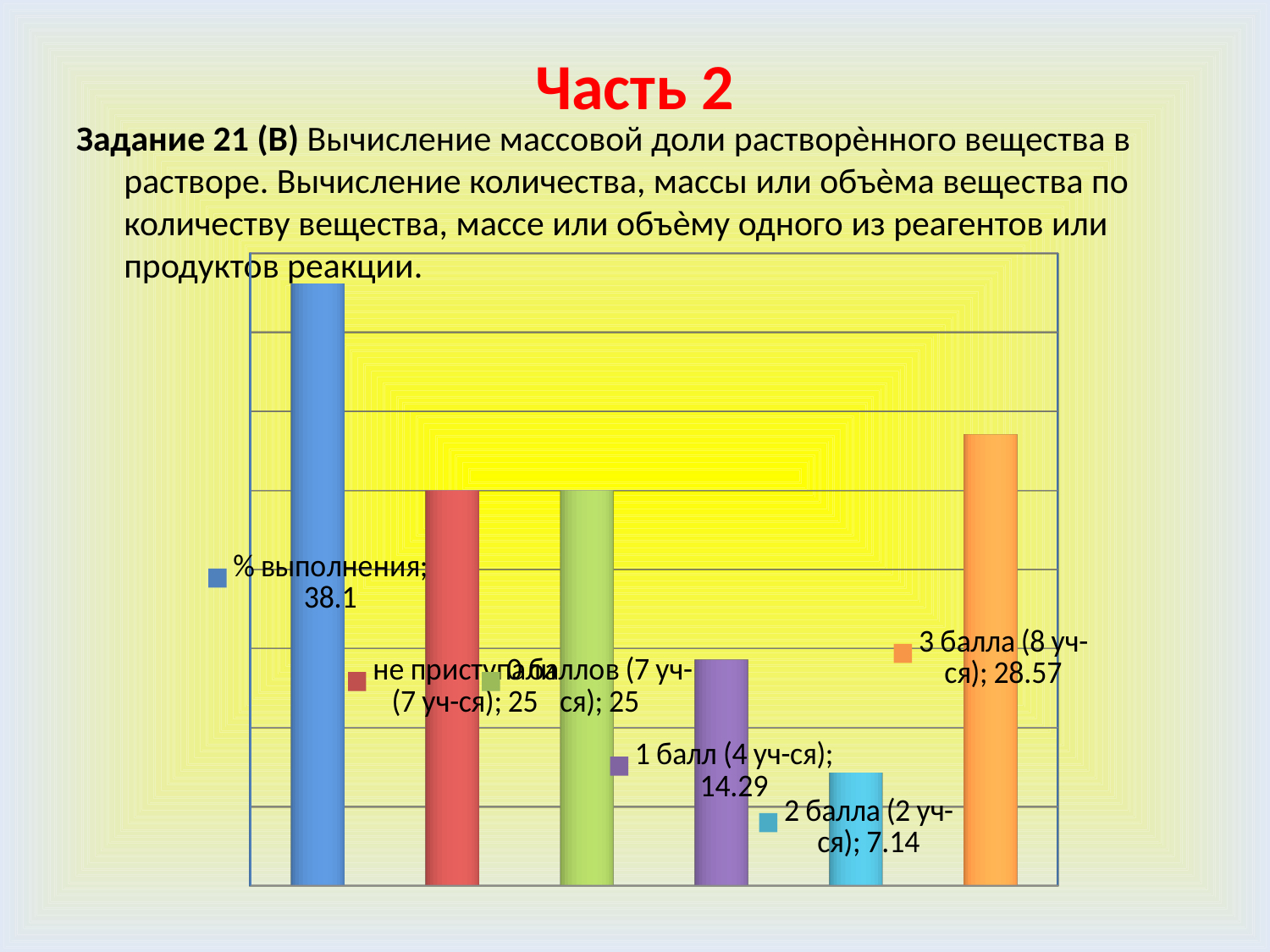
Which is larger, the value for "3 балла (8 уч-ся)" or the value for "1 балл (4 уч-ся)"? 3 балла (8 уч-ся) What kind of chart is shown on the slide? bar chart What is the value shown for the bar labelled "% выполнения"? 38.1 What is the value shown for "2 балла (2 уч-ся)"? 7.14 Which bar has the lowest value? 2 балла (2 уч-ся) How many bars are plotted in the chart? 6 What is the difference between the values for "1 балл (4 уч-ся)" and "2 балла (2 уч-ся)"? 7.15 Which bar has the highest value? % выполнения What is the value shown for "3 балла (8 уч-ся)"? 28.57 What is the value shown for "0 баллов (7 уч-ся)"? 25 What is the value shown for "1 балл (4 уч-ся)"? 14.29 What is the difference between the values for "% выполнения" and "3 балла (8 уч-ся)"? 9.53